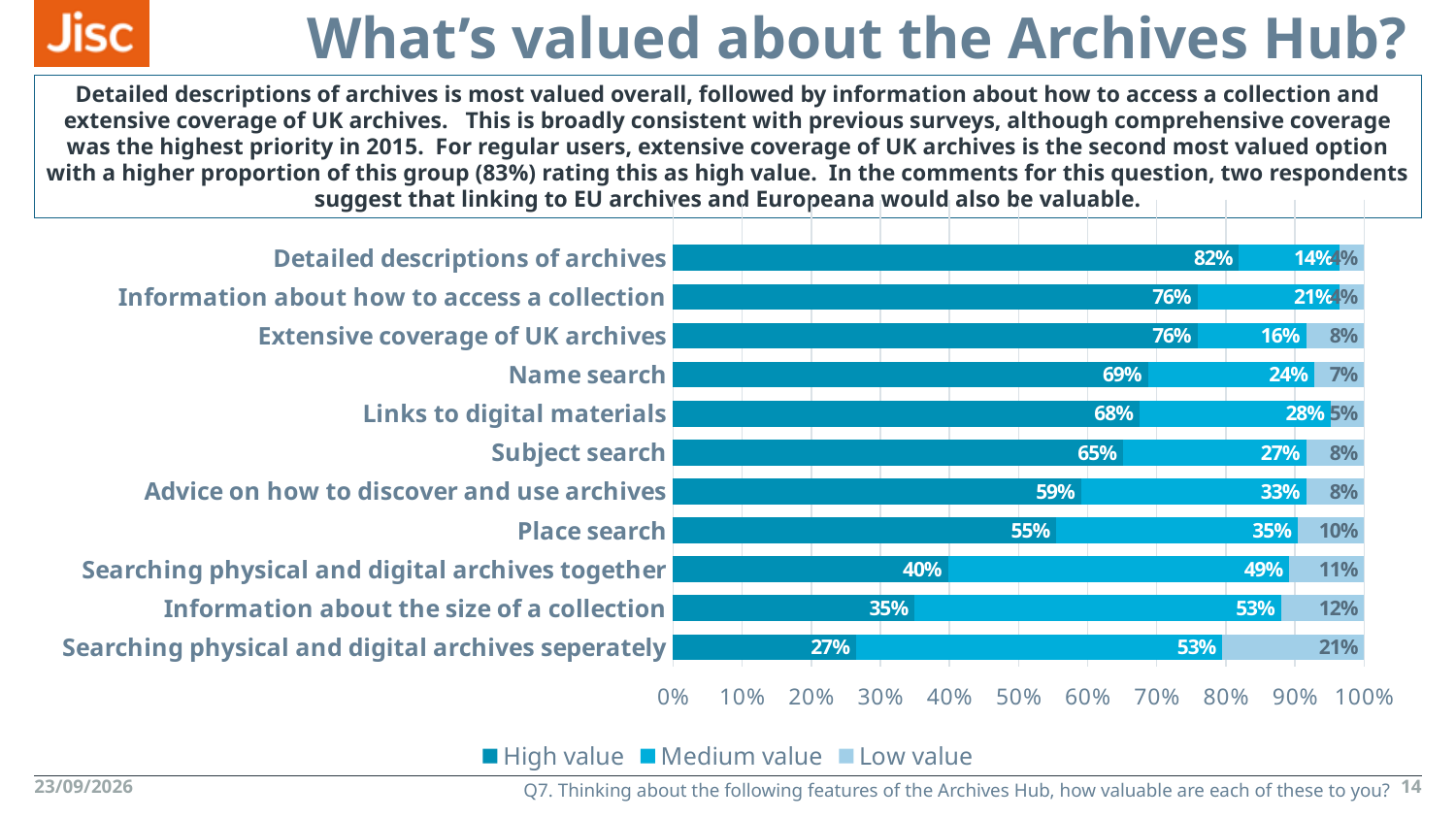
Is the high value percentage for 'Information about the size of a collection' greater or less than 40%? less What is the medium value percentage for 'Searching physical and digital archives together'? 49% How many series does the legend list? 3 Which feature has the lowest high value percentage? Searching physical and digital archives seperately What type of chart is shown on the slide? Stacked bar chart What percentage of respondents rated 'Detailed descriptions of archives' as high value? 82% Which has a larger high value percentage: 'Subject search' or 'Advice on how to discover and use archives'? Subject search What is the difference between the high value percentages for 'Name search' and 'Place search'? 14% How many features (categories) are listed in the chart? 11 Which feature has the highest high value percentage? Detailed descriptions of archives Which series is shown in the darkest blue colour in the legend? High value What is the low value percentage for 'Searching physical and digital archives seperately'? 21%